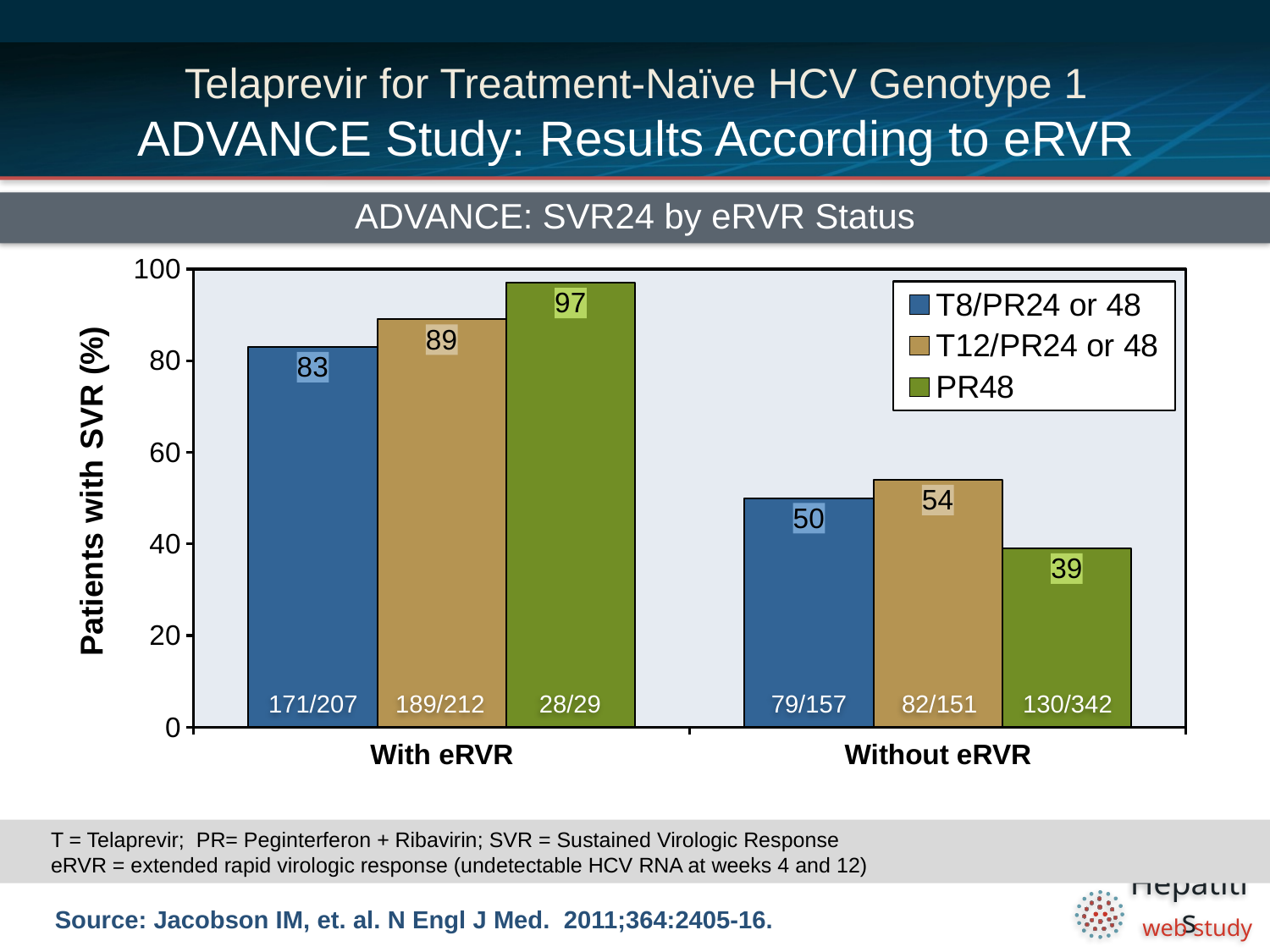
What is the patient fraction shown for T8/PR24 or 48 in the With eRVR group? 171/207 What is the SVR rate for PR48 in the With eRVR group? 97 What is the difference in SVR rate between PR48 with eRVR and PR48 without eRVR? 58 How many eRVR status groups are shown on the x axis? 2 What kind of chart is shown on the slide? Bar chart Which is larger: the SVR rate for T12/PR24 or 48 without eRVR or for T8/PR24 or 48 without eRVR? T12/PR24 or 48 What is the SVR rate for T8/PR24 or 48 in the Without eRVR group? 50 What is the SVR rate for T12/PR24 or 48 in the With eRVR group? 89 Which treatment arm has the lowest SVR rate in the Without eRVR group? PR48 What is the title of the chart? ADVANCE: SVR24 by eRVR Status Which treatment arm has the highest SVR rate in the With eRVR group? PR48 How many treatment arms does the legend list? 3